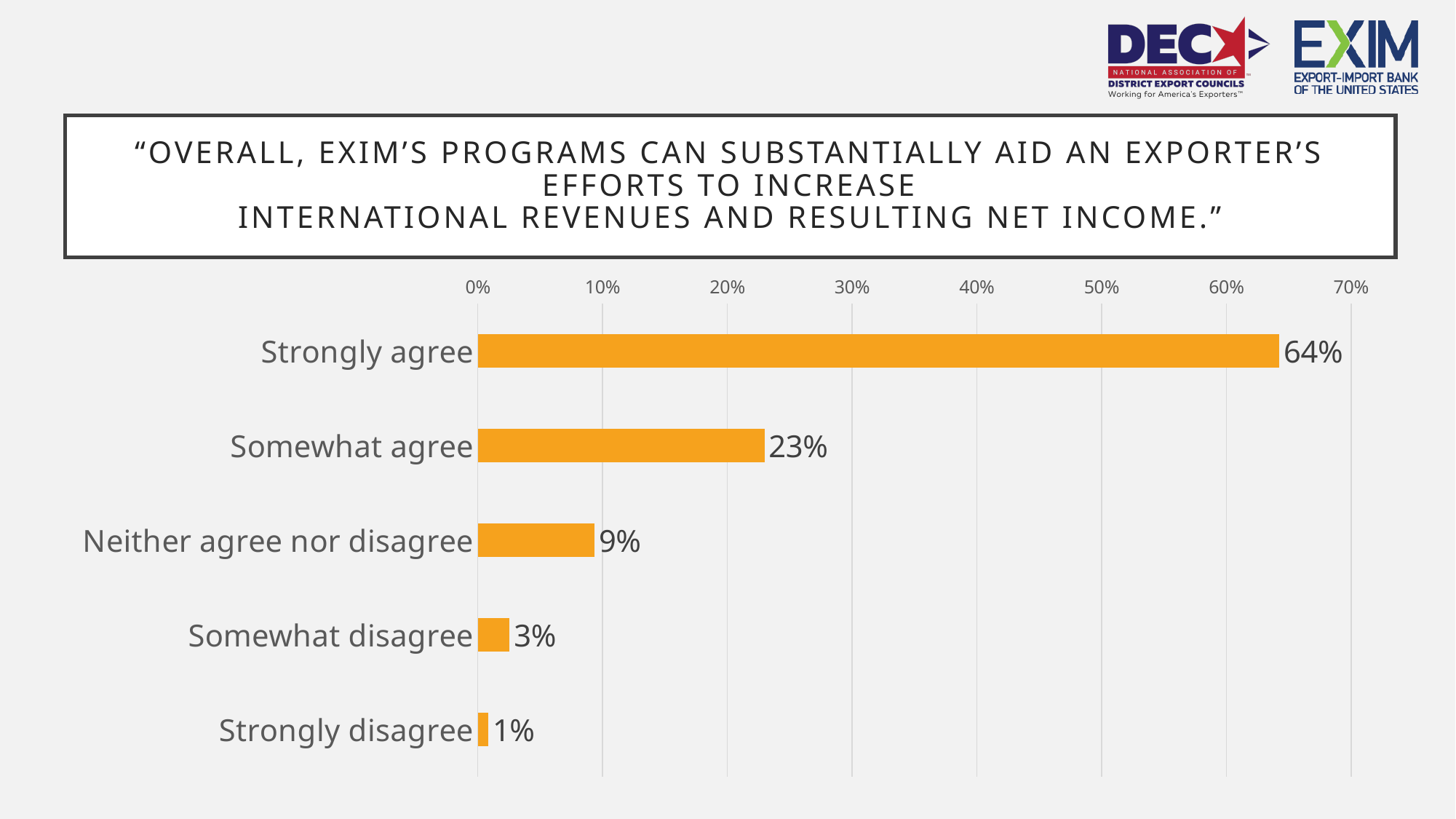
How many response categories are shown in the chart? 5 Which response category has the highest value? Strongly agree Which is larger, the value for "Somewhat disagree" or the value for "Neither agree nor disagree"? Neither agree nor disagree Is the value for "Strongly agree" greater or less than 60%? greater Which response category has the lowest value? Strongly disagree What is the value for "Somewhat agree"? 23% What is the combined value of "Strongly agree" and "Somewhat agree"? 87% What is the value for "Strongly disagree"? 1% What percentage of respondents chose "Strongly agree"? 64% What is the value for "Neither agree nor disagree"? 9% What is the difference between the "Strongly agree" and "Somewhat agree" values? 41% What kind of chart is shown on the slide? Bar chart